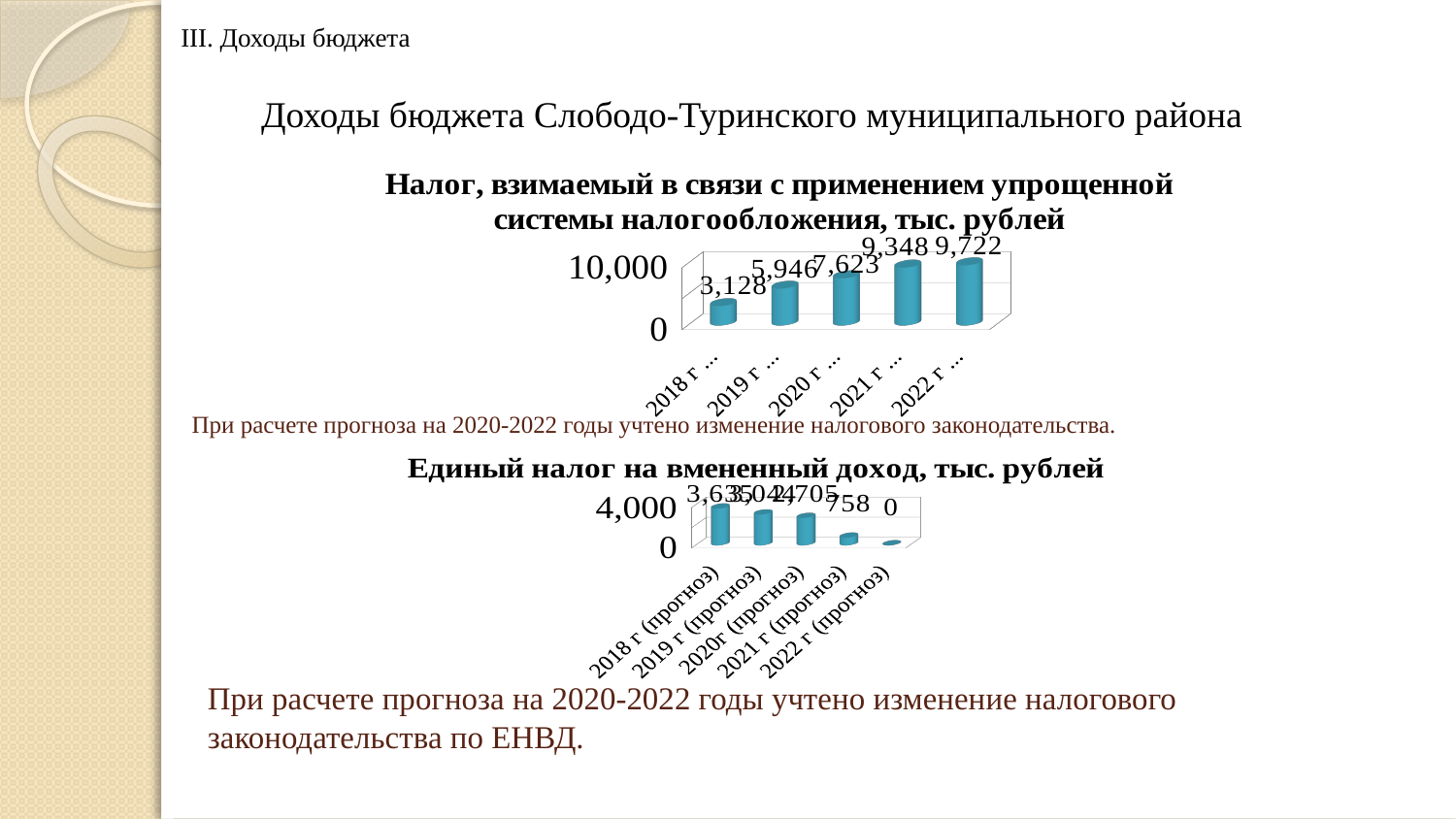
In the chart 'Единый налог на вмененный доход, тыс. рублей', which year has the highest value? 2018 г (прогноз) In the chart 'Единый налог на вмененный доход, тыс. рублей', do the values rise or fall from 2018 to 2022? fall In the chart 'Налог, взимаемый в связи с применением упрощенной системы налогообложения, тыс. рублей', do the values rise or fall from 2018 to 2022? rise In the chart 'Единый налог на вмененный доход, тыс. рублей', what is the value for 2022 г (прогноз)? 0 How many bars are shown in the chart 'Налог, взимаемый в связи с применением упрощенной системы налогообложения, тыс. рублей'? 5 In the chart 'Налог, взимаемый в связи с применением упрощенной системы налогообложения, тыс. рублей', which year has the lowest value? 2018 In the chart 'Единый налог на вмененный доход, тыс. рублей', what is the value for 2021 г (прогноз)? 758 In the chart 'Налог, взимаемый в связи с применением упрощенной системы налогообложения, тыс. рублей', what is the value for 2022? 9,722 In the chart 'Налог, взимаемый в связи с применением упрощенной системы налогообложения, тыс. рублей', what is the difference between the 2022 and 2018 values? 6,594 In the chart 'Налог, взимаемый в связи с применением упрощенной системы налогообложения, тыс. рублей', which year has the highest value? 2022 In the chart 'Налог, взимаемый в связи с применением упрощенной системы налогообложения, тыс. рублей', what is the value for 2018? 3,128 What kind of chart is 'Единый налог на вмененный доход, тыс. рублей'? bar chart